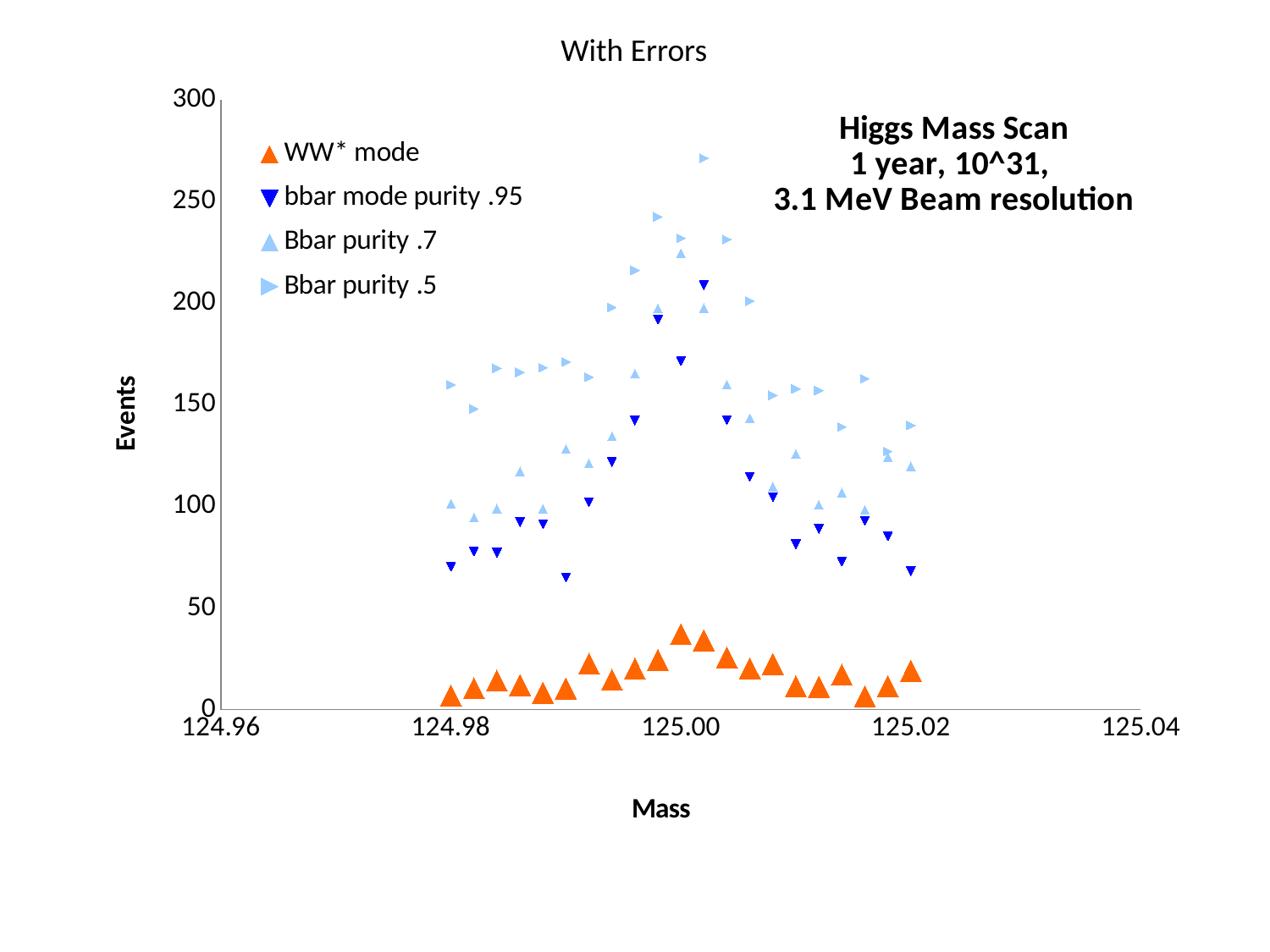
What is the label of the vertical axis? Events What is the title of the chart? Higgs Mass Scan 1 year, 10^31, 3.1 MeV Beam resolution What kind of chart is shown on the slide? Scatter chart How many series does the legend list? 4 Which series reaches the highest value on the chart? Bbar purity .5 Which series has the lowest values across the whole mass range? WW* mode Is the value for bbar mode purity .95 at mass 124.98 greater or less than 100? less Is the highest value for Bbar purity .5 greater or less than 250? greater Is the value for WW* mode at mass 125.00 greater or less than 50? less At mass 125.00, which is larger: the value for bbar mode purity .95 or the value for WW* mode? bbar mode purity .95 Do the WW* mode values rise or fall as mass increases from 124.98 to 125.00? rise